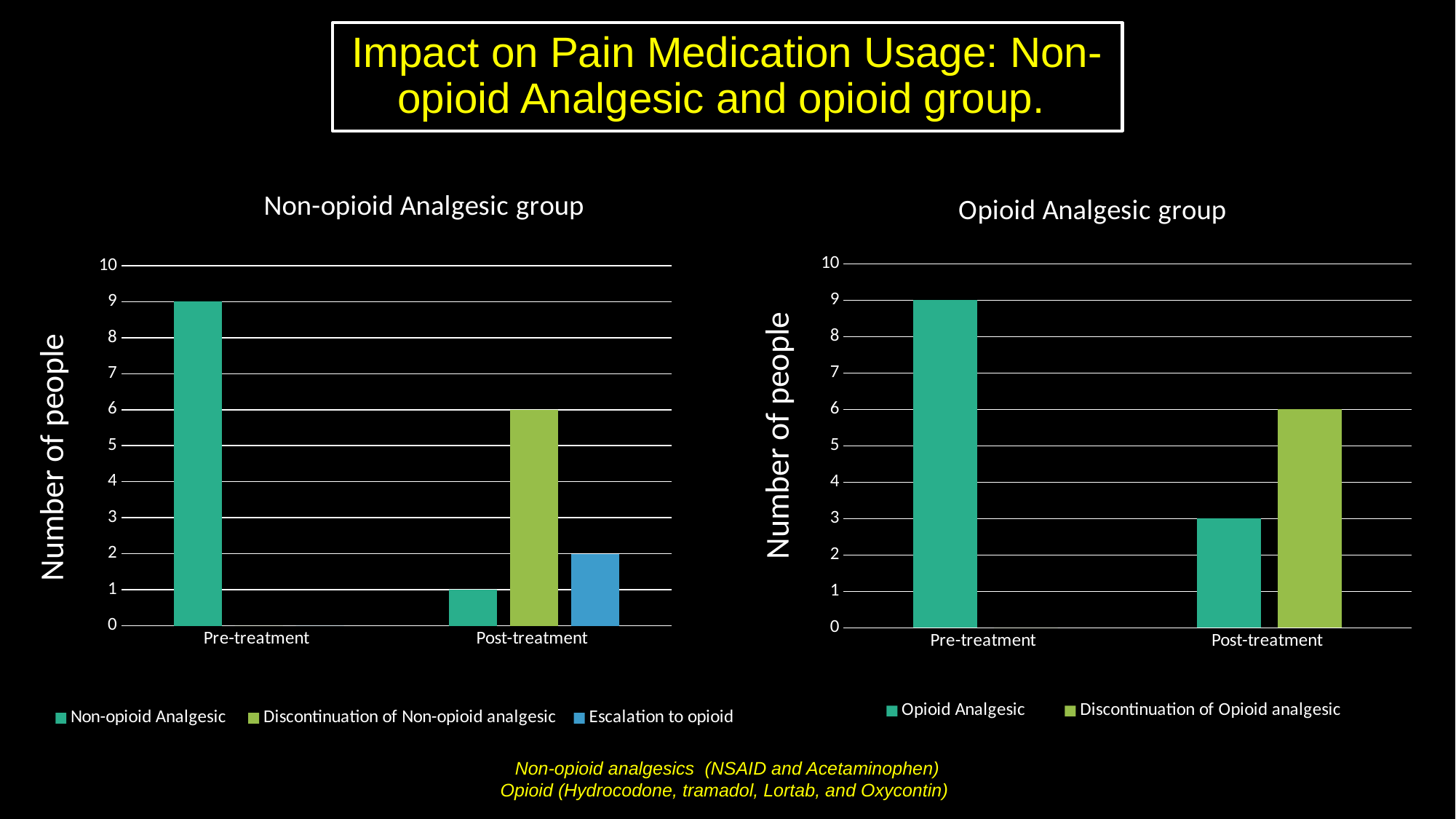
In the Opioid Analgesic group chart, what is the value for Discontinuation of Opioid analgesic at Post-treatment? 6 How many series does the legend of the Non-opioid Analgesic group chart list? 3 In the Non-opioid Analgesic group chart, what is the difference between the Non-opioid Analgesic value at Pre-treatment and at Post-treatment? 8 In the Opioid Analgesic group chart, what is the difference between the Opioid Analgesic value at Pre-treatment and at Post-treatment? 6 In the Non-opioid Analgesic group chart, what is the value for Discontinuation of Non-opioid analgesic at Post-treatment? 6 In the Opioid Analgesic group chart, which is larger at Post-treatment: Opioid Analgesic or Discontinuation of Opioid analgesic? Discontinuation of Opioid analgesic In the Opioid Analgesic group chart, does the Opioid Analgesic value rise or fall from Pre-treatment to Post-treatment? Fall In the Opioid Analgesic group chart, what is the value for Opioid Analgesic at Post-treatment? 3 In the Non-opioid Analgesic group chart, which series has the highest value at Post-treatment? Discontinuation of Non-opioid analgesic What kind of chart is the Opioid Analgesic group chart? Bar chart In the Non-opioid Analgesic group chart, what is the value for Non-opioid Analgesic at Pre-treatment? 9 In the Non-opioid Analgesic group chart, what is the value for Escalation to opioid at Post-treatment? 2